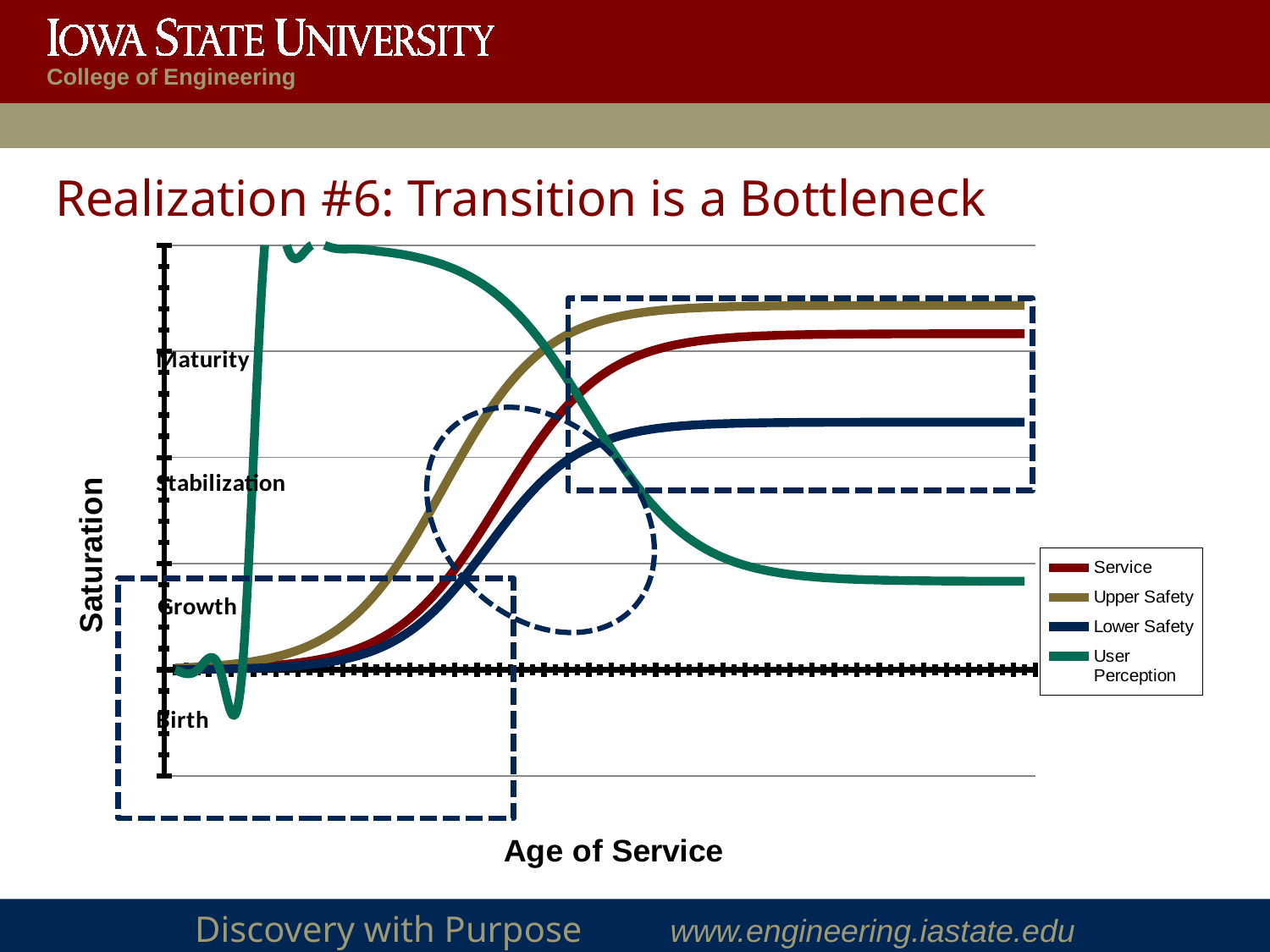
What kind of chart is shown on the slide? line chart At the right end of the chart, which is higher: the Service curve or the Lower Safety curve? Service What is the label of the horizontal axis? Age of Service How many stage labels (Birth, Growth, etc.) are shown along the vertical axis? 4 Which of the three safety/service curves levels off lowest at the right end of the chart? Lower Safety Does the User Perception curve rise or fall across the right half of the chart? fall Does the Service curve rise or fall as Age of Service increases? rise How many series does the legend list? 4 At the right end of the chart, which is higher: Upper Safety or User Perception? Upper Safety What is the title of the slide containing the chart? Realization #6: Transition is a Bottleneck Which series is plotted in green? User Perception Which series reaches the highest level at the right end of the chart? Upper Safety